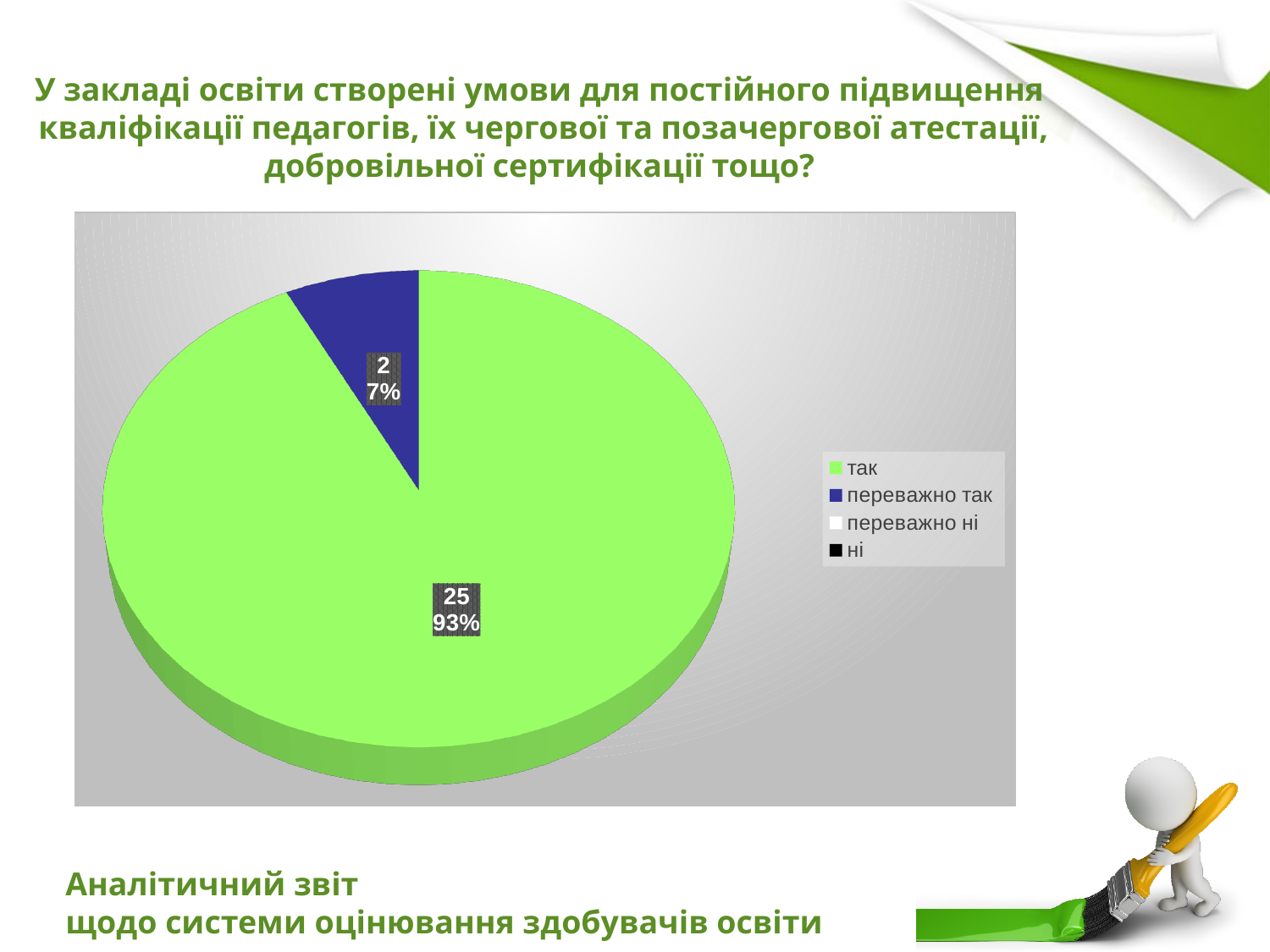
How many respondents answered "переважно так"? 2 What is the total of the two labelled slices, "так" and "переважно так"? 27 How many respondents answered "так"? 25 What share of the pie does "так" take? 93% What colour is the slice for "так"? green How many entries does the legend list? 4 Which of the two labelled slices is smaller, "так" or "переважно так"? переважно так What colour is the slice for "переважно так"? blue What is the difference between the counts for "так" and "переважно так"? 23 What share of the pie does "переважно так" take? 7% Which category has the largest slice of the pie? так What kind of chart is shown on the slide? pie chart